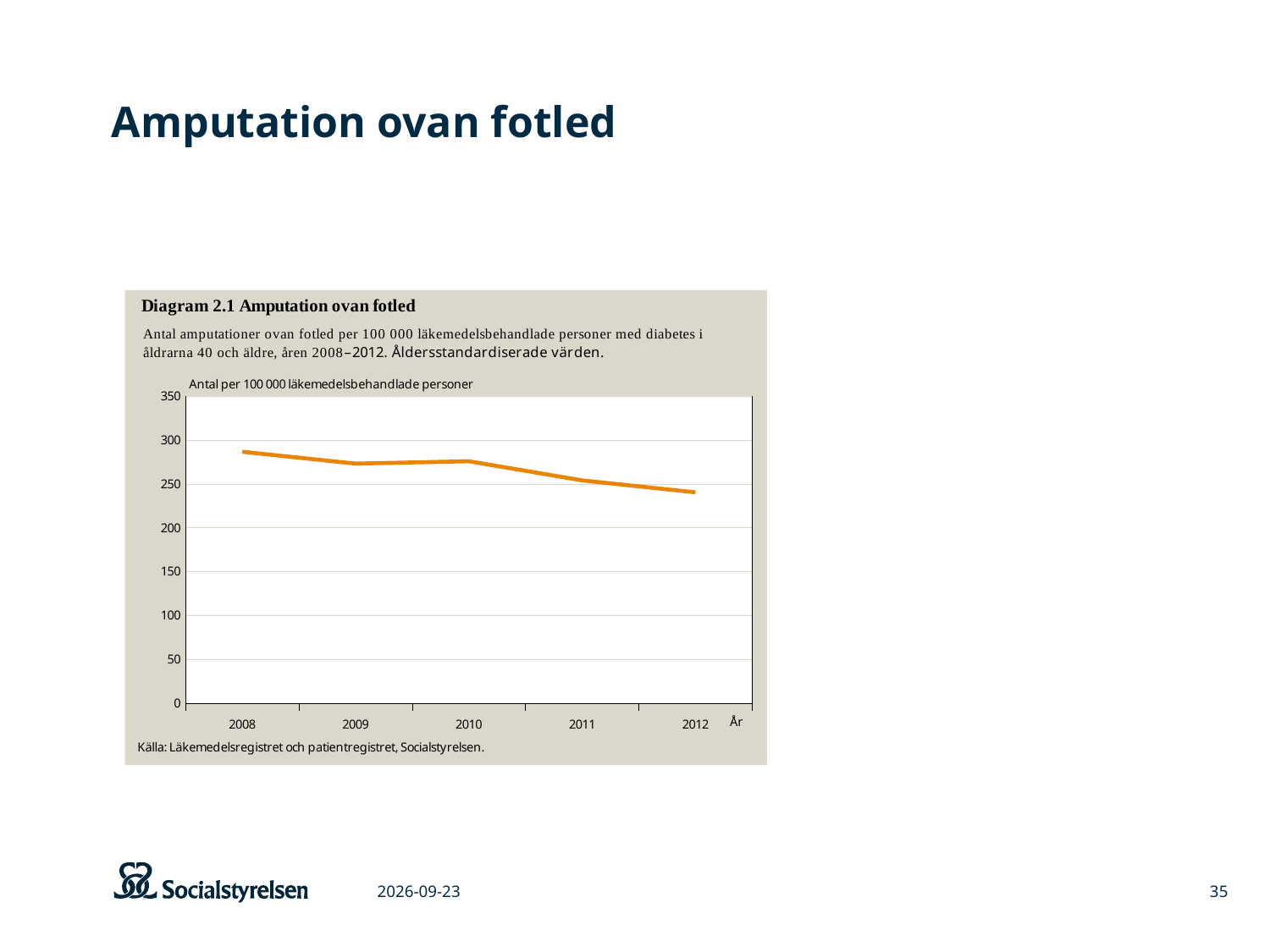
Is the value for 2010 greater or less than 250? greater Which year has the larger value, 2008 or 2012? 2008 Do the values generally rise or fall from 2008 to 2012? fall Is the value for 2012 greater or less than 250? less What is the title of the diagram shown on the slide? Diagram 2.1 Amputation ovan fotled How many years are plotted on the x axis of the chart? 5 Which year has the highest value in the chart? 2008 What is the label on the x axis of the chart? År Which year has the lowest value in the chart? 2012 Is the value for 2011 greater or less than 300? less What kind of chart is Diagram 2.1 Amputation ovan fotled? line chart